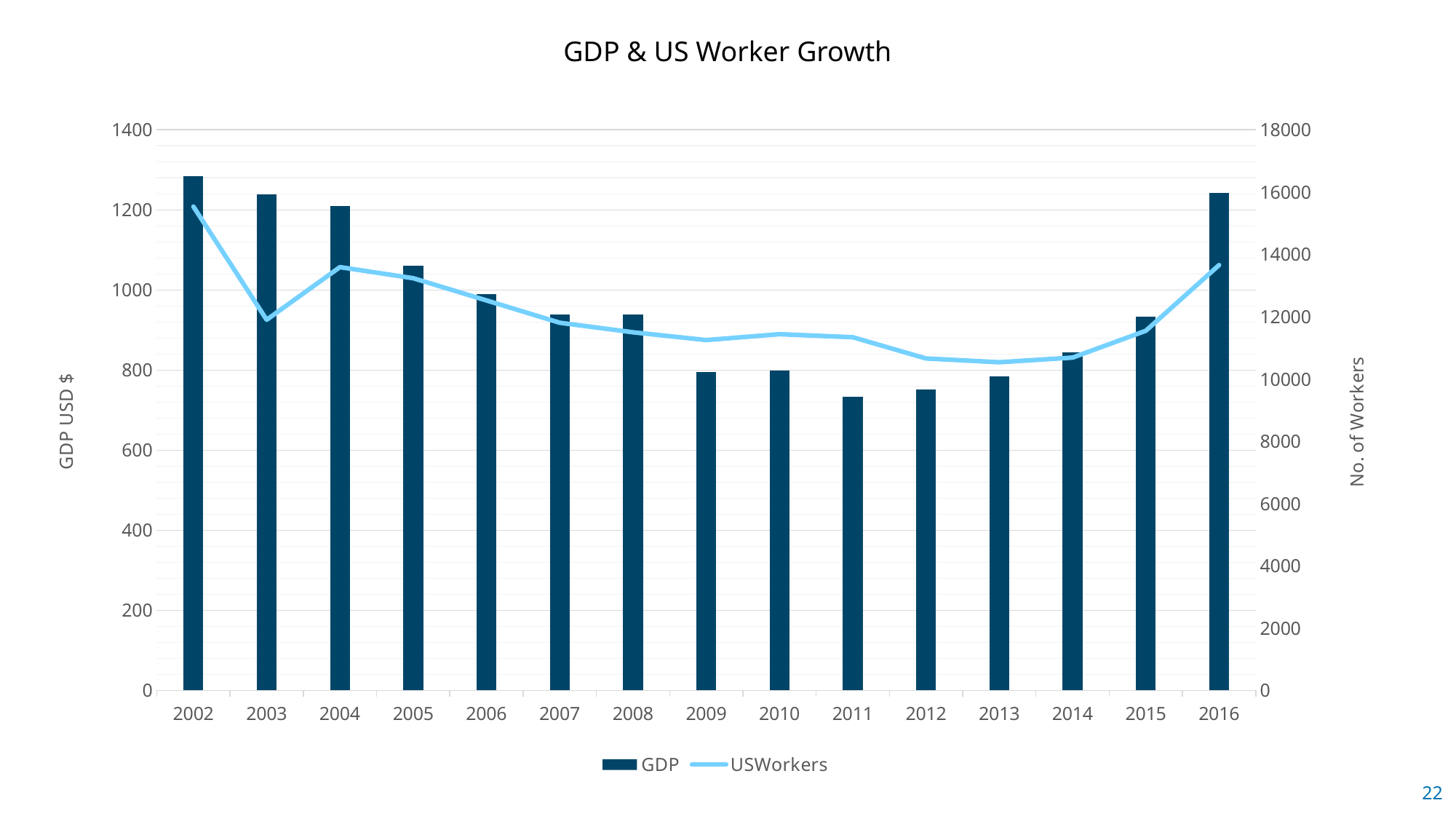
Does GDP generally rise or fall from 2002 to 2011? fall Is the USWorkers value for 2002 greater or less than 14000? greater Which year has the highest GDP bar? 2002 How many years are shown on the x axis? 15 Which year has the larger GDP bar, 2004 or 2005? 2004 What is the title of the chart? GDP & US Worker Growth What is the title of the right-hand vertical axis? No. of Workers Is the USWorkers value for 2009 greater or less than 12000? less Is the GDP value for 2011 greater or less than 800? less In which year does the USWorkers line reach its highest point? 2002 How many series does the legend list? 2